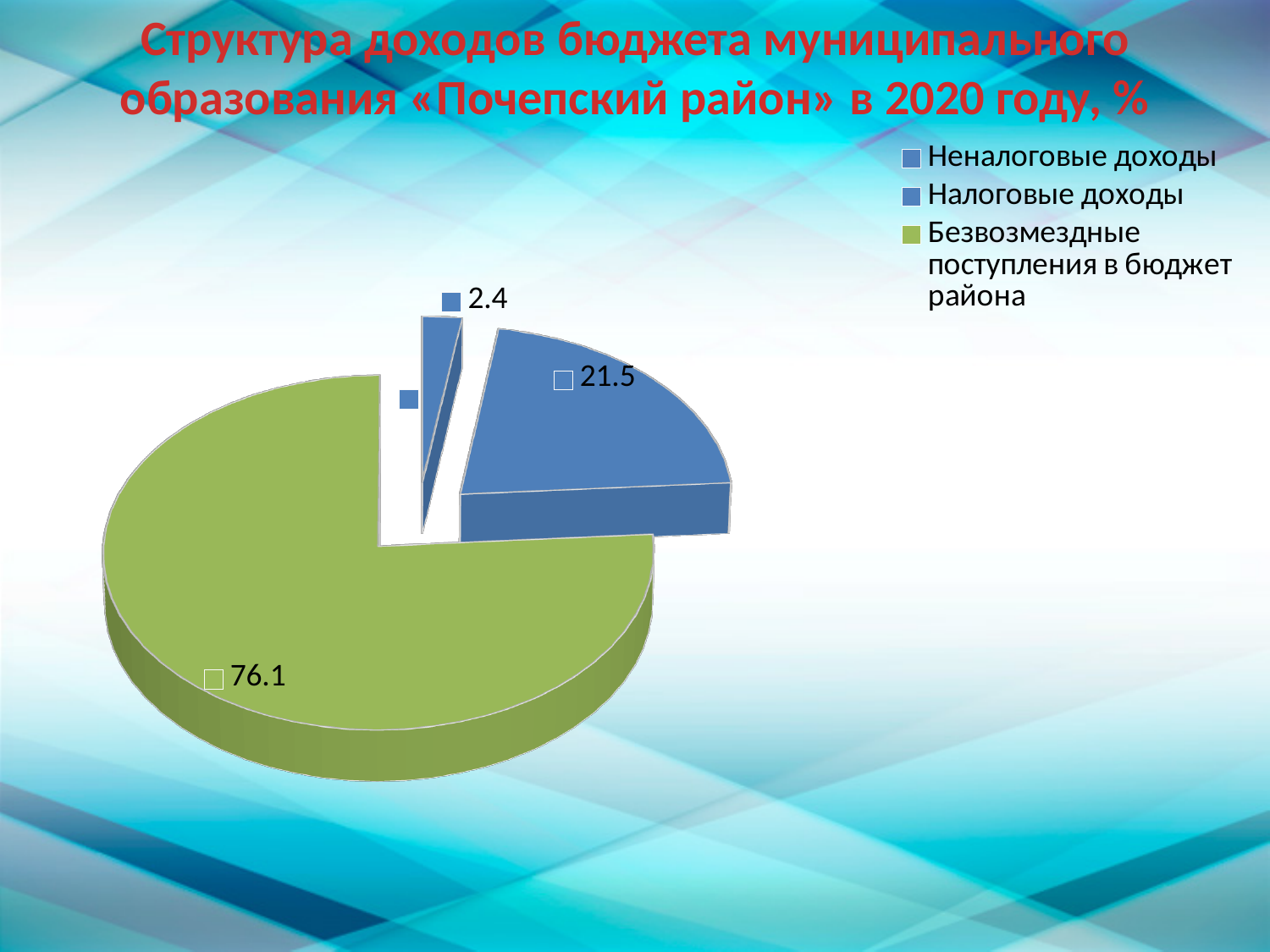
What is the difference between the values for Налоговые доходы and Неналоговые доходы? 19.1 How many slices does the pie chart have? 3 What is the value shown for Налоговые доходы? 21.5 What is the value shown for Неналоговые доходы? 2.4 What is the difference between the values for Безвозмездные поступления в бюджет района and Налоговые доходы? 54.6 What type of chart is shown on the slide? Pie chart Which is larger, the value for Налоговые доходы or the value for Неналоговые доходы? Налоговые доходы What colour is the slice for Безвозмездные поступления в бюджет района? Green Which category has the largest slice of the pie? Безвозмездные поступления в бюджет района What is the value shown for Безвозмездные поступления в бюджет района? 76.1 Which category has the smallest slice of the pie? Неналоговые доходы How many entries does the legend list? 3